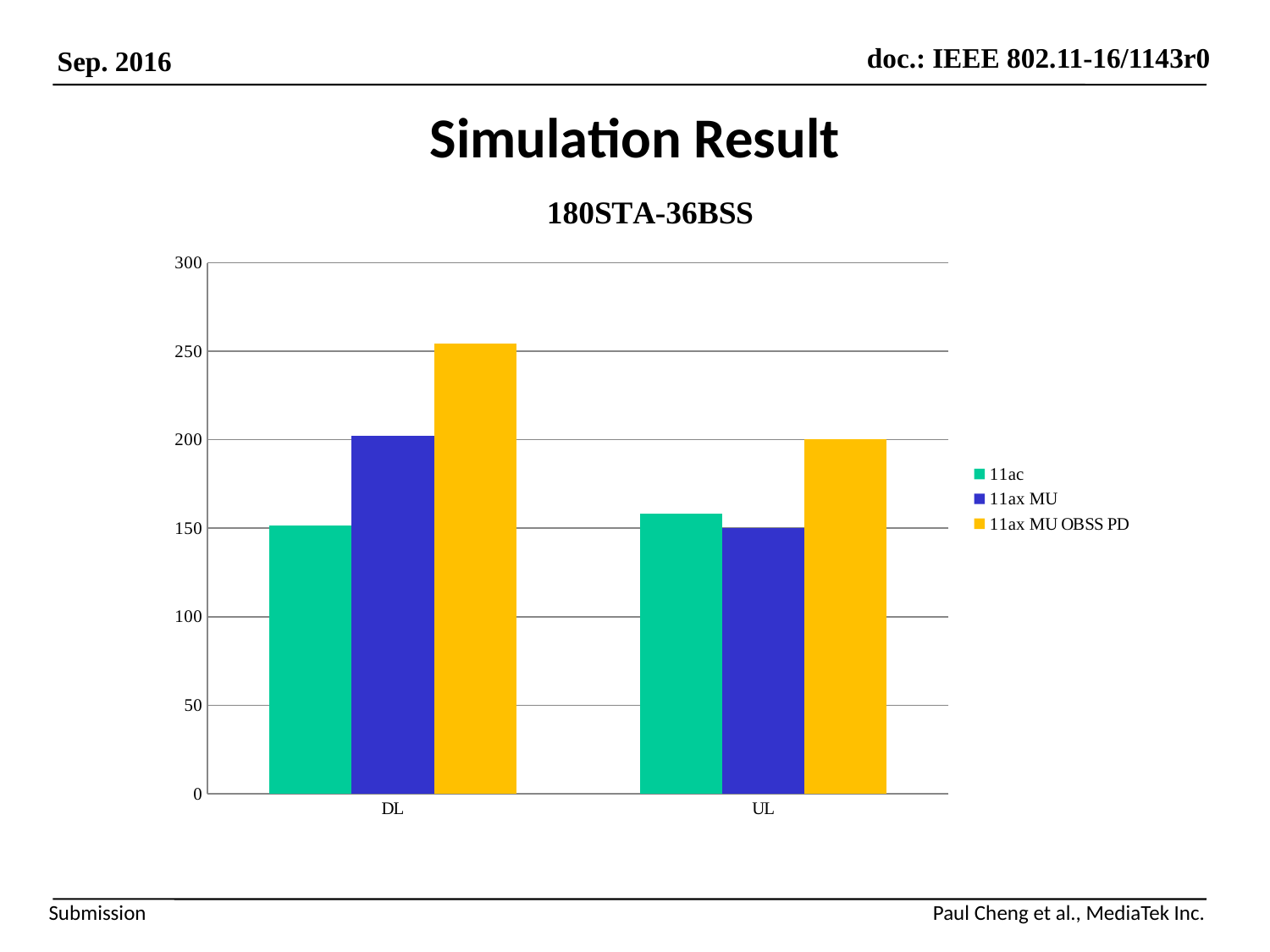
Which series has the lowest value for DL? 11ac Is the value for 11ax MU OBSS PD in DL greater or less than 250? greater What type of chart is shown on the slide? bar chart What is the title of the chart? 180STA-36BSS Is the value for 11ac in DL greater or less than 200? less Which series has the highest value for UL? 11ax MU OBSS PD For DL, which is larger: 11ax MU or 11ac? 11ax MU How many series does the legend list? 3 Which series has the highest value for DL? 11ax MU OBSS PD Is the value for 11ax MU in UL greater or less than 200? less Which series is shown in yellow in the legend? 11ax MU OBSS PD How many categories are shown on the x axis? 2